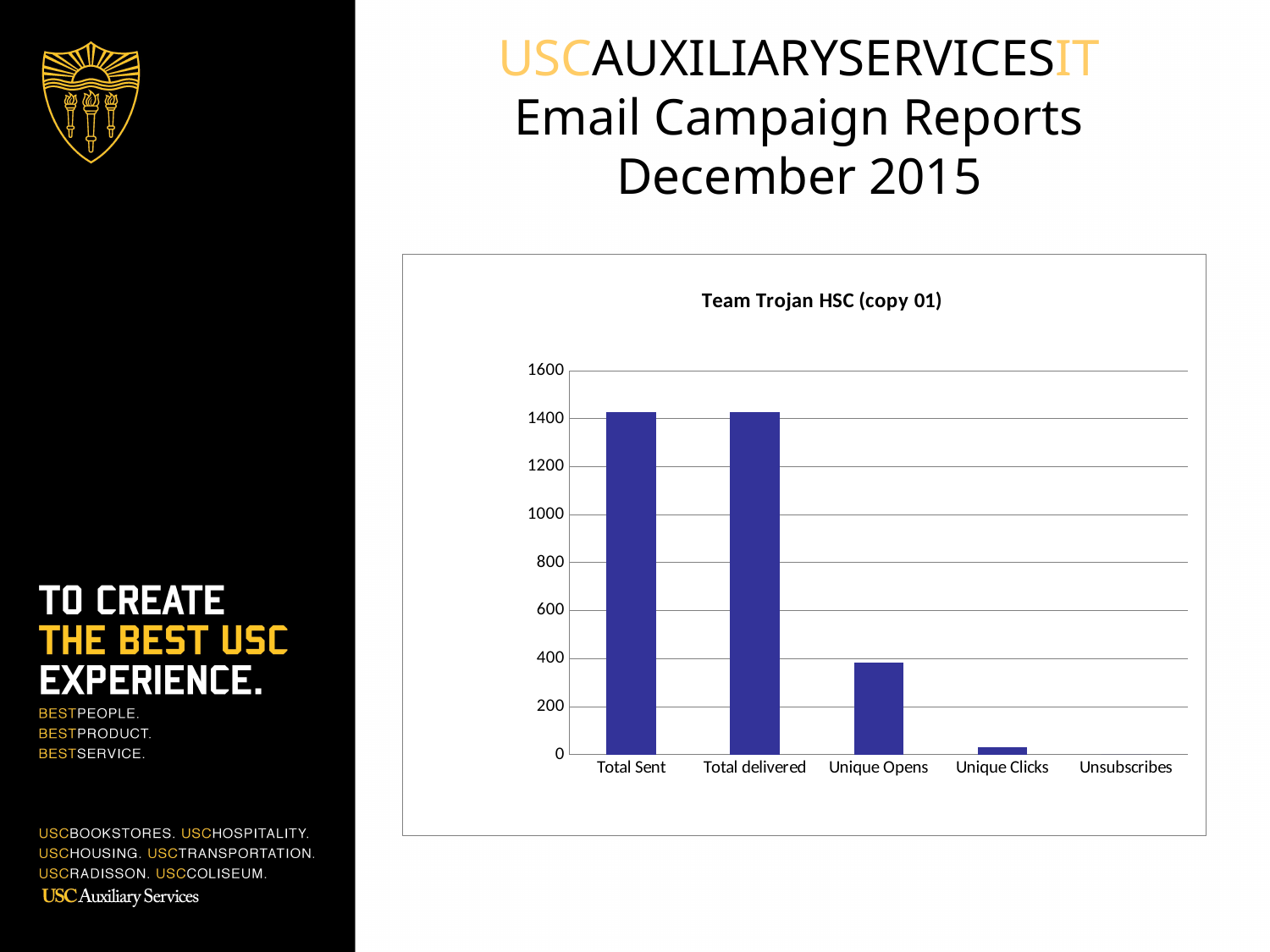
Which category has the lowest value in the chart? Unsubscribes Which is larger, the value for Unique Opens or the value for Unique Clicks? Unique Opens Is the value for Total delivered greater or less than 1000? greater What is the title of the chart? Team Trojan HSC (copy 01) Is the value for Unique Opens greater or less than 600? less Is the value for Unique Clicks greater or less than 200? less Which is larger, the value for Total delivered or the value for Unique Opens? Total delivered What kind of chart is shown on the slide? bar chart How many categories are shown on the x axis of the chart? 5 Do the values generally rise or fall moving from left to right along the x axis? fall